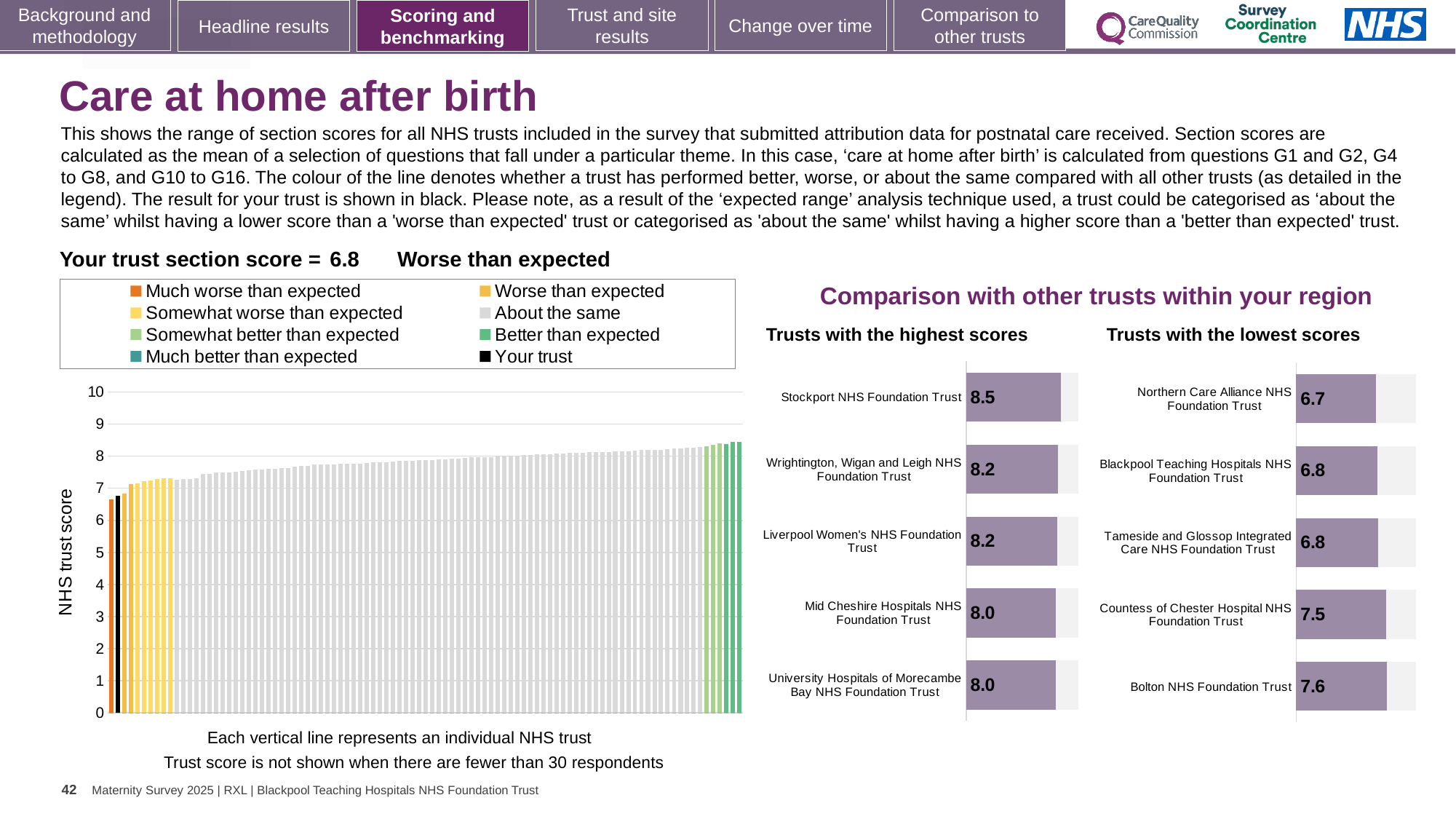
In the main 'NHS trust score' chart, is the value for the black 'Your trust' bar greater or less than 7? less In the 'Trusts with the lowest scores' chart, which has the larger score: Bolton NHS Foundation Trust or Tameside and Glossop Integrated Care NHS Foundation Trust? Bolton NHS Foundation Trust In the 'Trusts with the highest scores' chart, which trust has the highest score? Stockport NHS Foundation Trust In the main 'NHS trust score' chart, what colour represents 'Your trust' in the legend? Black In the main 'NHS trust score' chart, do the trust scores rise or fall from left to right? Rise In the 'Trusts with the highest scores' chart, what is the score for Stockport NHS Foundation Trust? 8.5 In the 'Trusts with the highest scores' chart, what is the difference between the scores of Stockport NHS Foundation Trust and Mid Cheshire Hospitals NHS Foundation Trust? 0.5 What kind of chart is the main 'NHS trust score' chart on the left? Bar chart How many trusts are shown in the 'Trusts with the highest scores' chart? 5 How many entries does the legend of the main 'NHS trust score' chart list? 8 In the 'Trusts with the lowest scores' chart, which trust has the lowest score? Northern Care Alliance NHS Foundation Trust In the 'Trusts with the lowest scores' chart, what is the score for Countess of Chester Hospital NHS Foundation Trust? 7.5